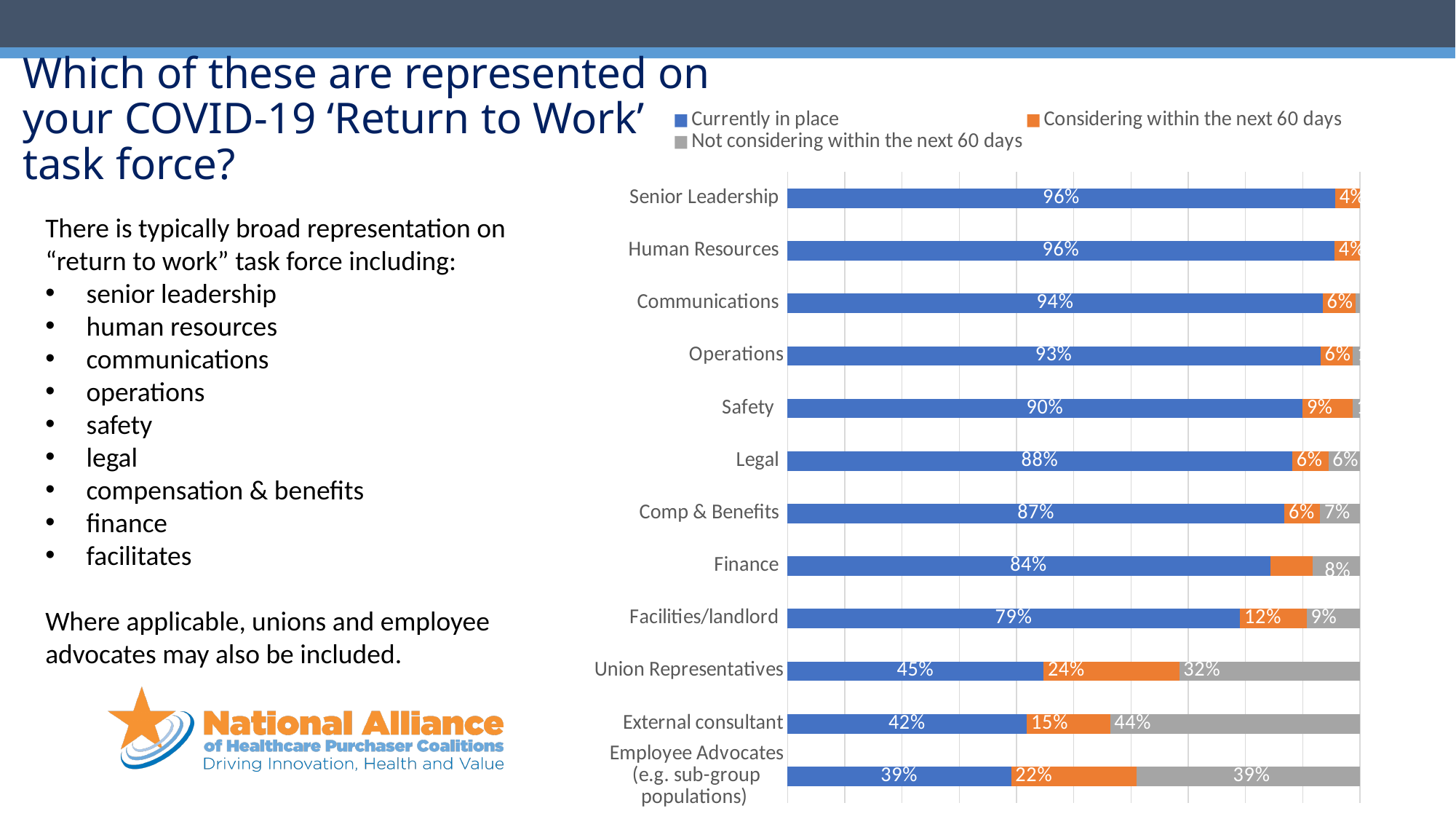
What is the 'Considering within the next 60 days' value for Union Representatives? 24% What is the 'Not considering within the next 60 days' value for External consultant? 44% What is the difference between the 'Currently in place' values for Safety and Finance? 6% What is the 'Currently in place' value for Facilities/landlord? 79% Which category has the highest 'Not considering within the next 60 days' value? External consultant Which category has the lowest 'Currently in place' value? Employee Advocates (e.g. sub-group populations) How many series does the legend list? 3 How many categories are shown on the chart? 12 Which is larger, the 'Currently in place' value for Union Representatives or for External consultant? Union Representatives What kind of chart is shown on the slide? Stacked bar chart What percentage of respondents report Senior Leadership is currently in place on their task force? 96% Which colour represents 'Considering within the next 60 days' in the chart? Orange